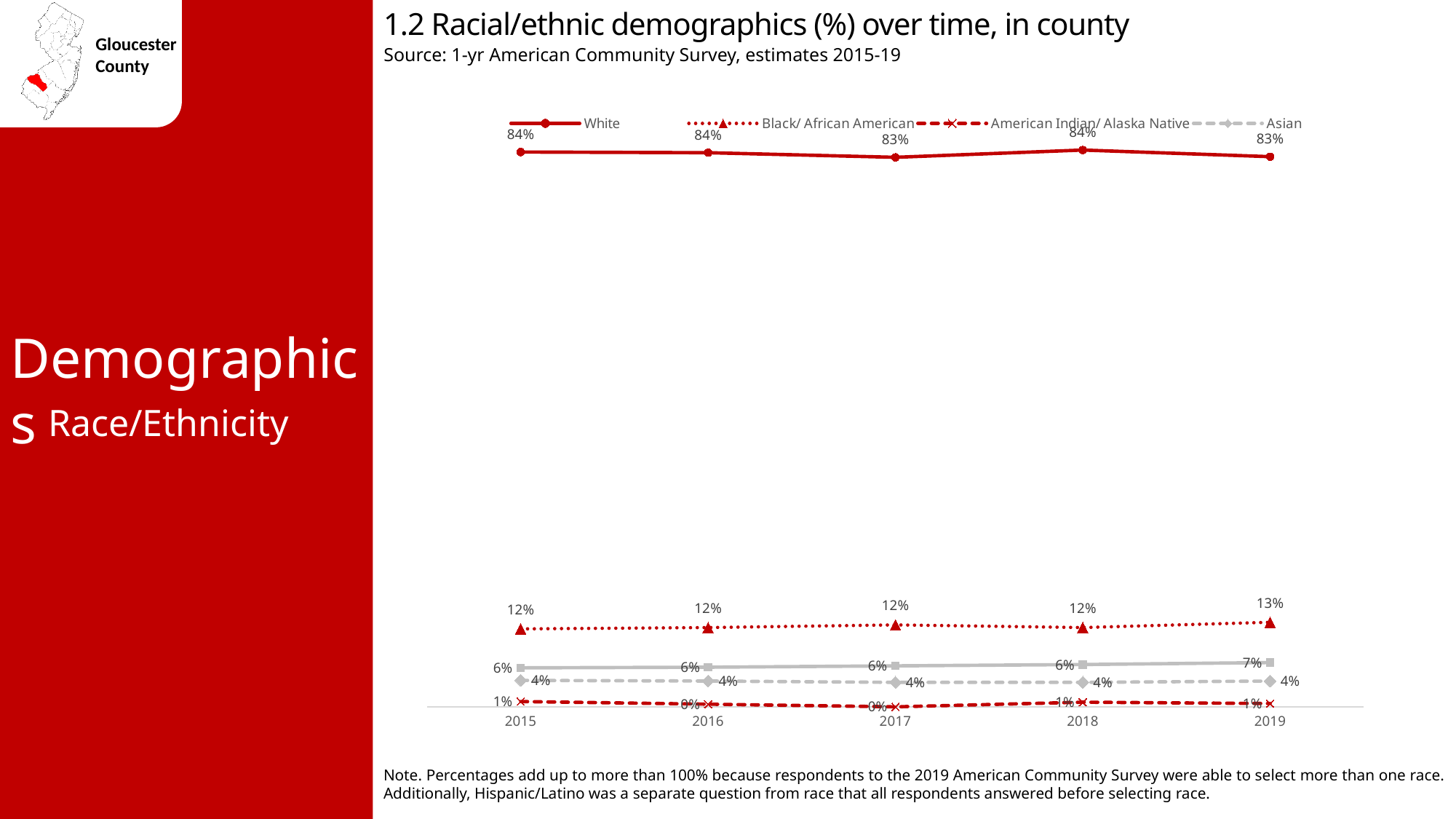
What is the title of the chart? 1.2 Racial/ethnic demographics (%) over time, in county How many years are shown on the x axis? 5 What is the value for Black/ African American in 2019? 13% Which is larger in 2019, the Black/ African American value or the Asian value? Black/ African American What kind of chart is this? Line chart What is the difference between the White value and the Black/ African American value in 2015? 72 percentage points What is the value for Asian in 2018? 4% What is the source cited for the chart? 1-yr American Community Survey, estimates 2015-19 In which year is the Black/ African American value highest? 2019 Does the White value rise or fall from 2018 to 2019? Fall What is the value for American Indian/ Alaska Native in 2016? 0% What is the value for White in 2017? 83%